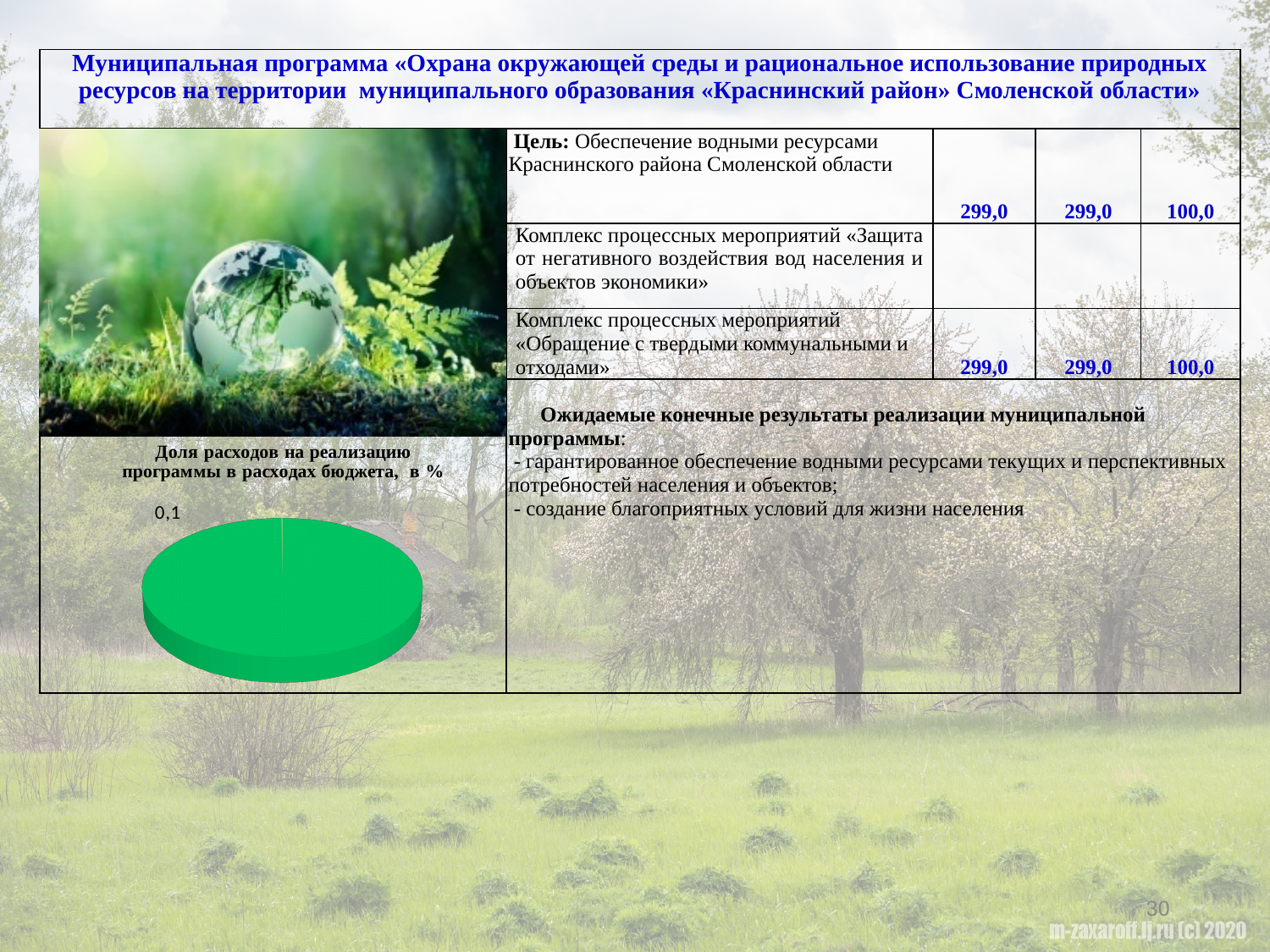
What value is printed as the data label on the pie chart? 0,1 In what unit does the pie chart title say the share is expressed? % What is the title of the pie chart? Доля расходов на реализацию программы в расходах бюджета, в % What kind of chart is shown on the slide? pie chart How many data labels are printed on the pie chart? 1 What colour is the pie chart's slice? green